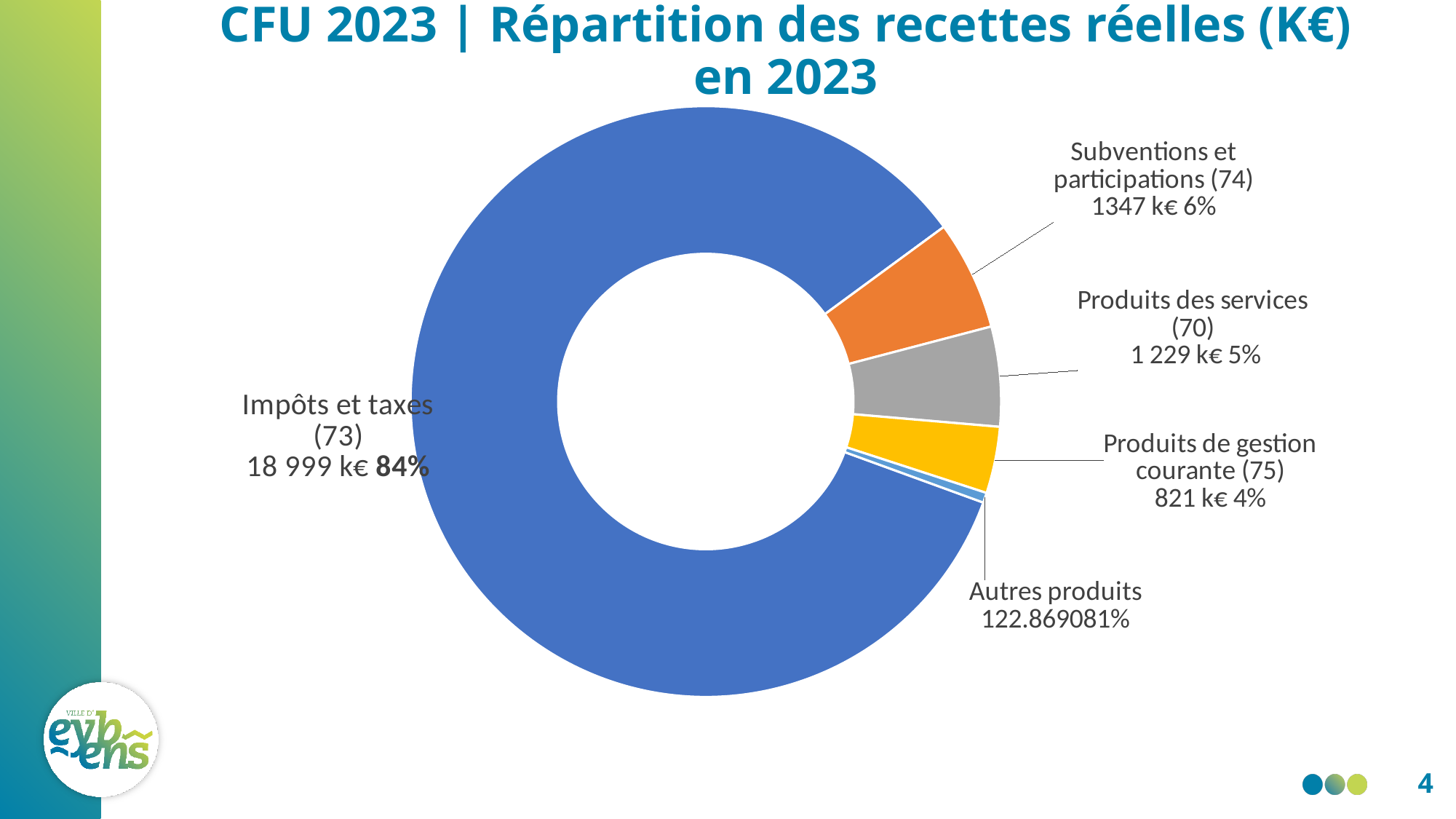
What is the difference between Subventions et participations (74) and Produits des services (70)? 118 k€ What is the value shown for Impôts et taxes (73)? 18 999 k€ What is the title of the chart? CFU 2023 | Répartition des recettes réelles (K€) en 2023 Which category has the largest slice? Impôts et taxes (73) What is the value shown for Subventions et participations (74)? 1347 k€ What share of the total does Impôts et taxes (73) represent? 84% What is the value shown for Produits des services (70)? 1 229 k€ Which category has the smallest slice? Autres produits What share of the total does Produits de gestion courante (75) represent? 4% How many categories (slices) does the chart show? 5 What is the value shown for Produits de gestion courante (75)? 821 k€ What kind of chart is shown on the slide? Doughnut (pie) chart